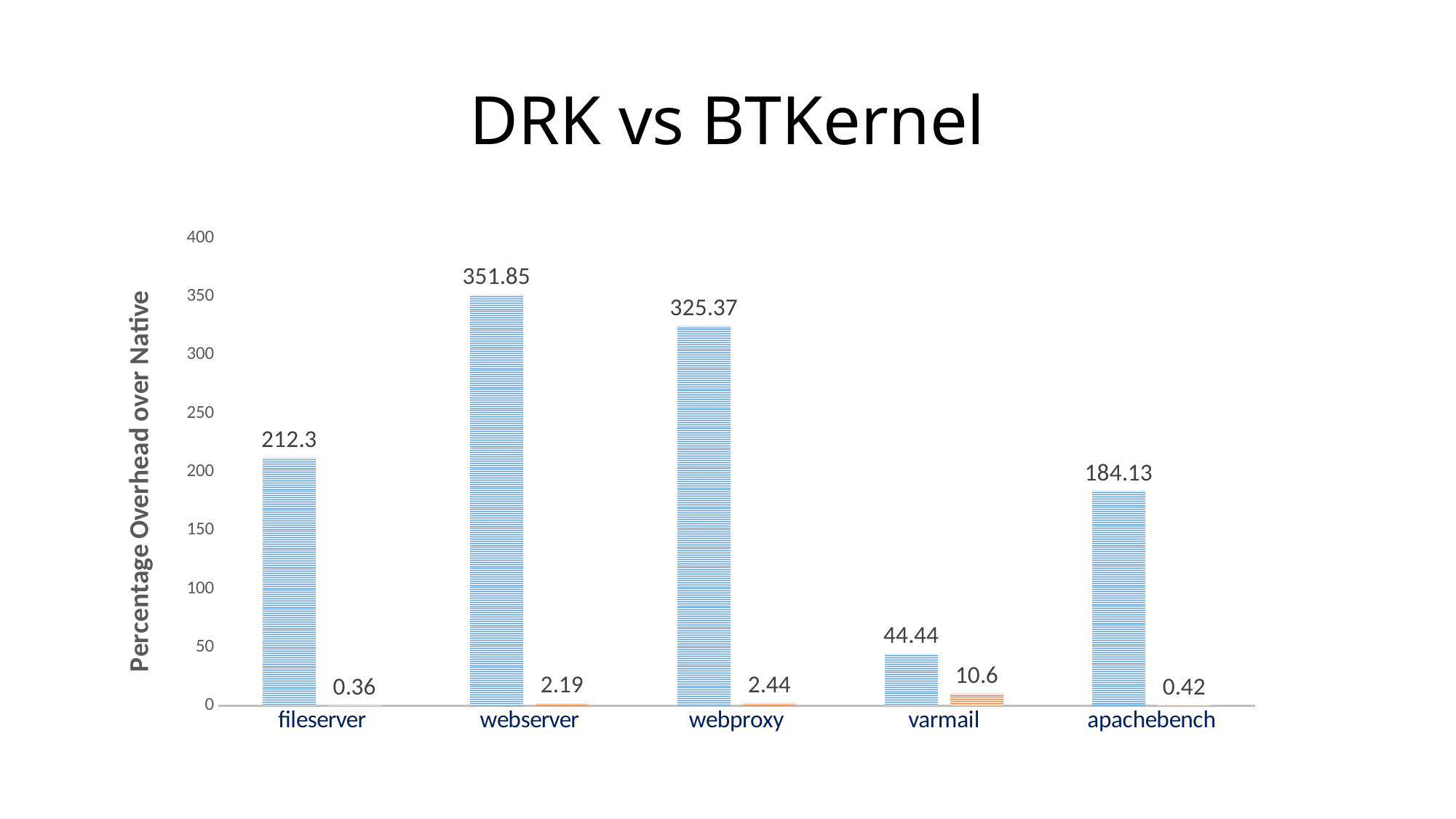
What is the value of the orange bar for varmail? 10.6 What is the value of the orange bar for fileserver? 0.36 What is the difference between the blue and orange bar values for varmail? 33.84 How many categories are shown on the x axis? 5 Which category has the lowest blue bar? varmail What is the value of the blue bar for apachebench? 184.13 Which is larger, the blue bar for fileserver or the blue bar for apachebench? fileserver What is the difference between the blue bar values for webserver and webproxy? 26.48 Which category has the highest orange bar? varmail What kind of chart is shown on the slide? bar chart Which category has the highest blue bar? webserver What is the value of the blue bar for webserver? 351.85